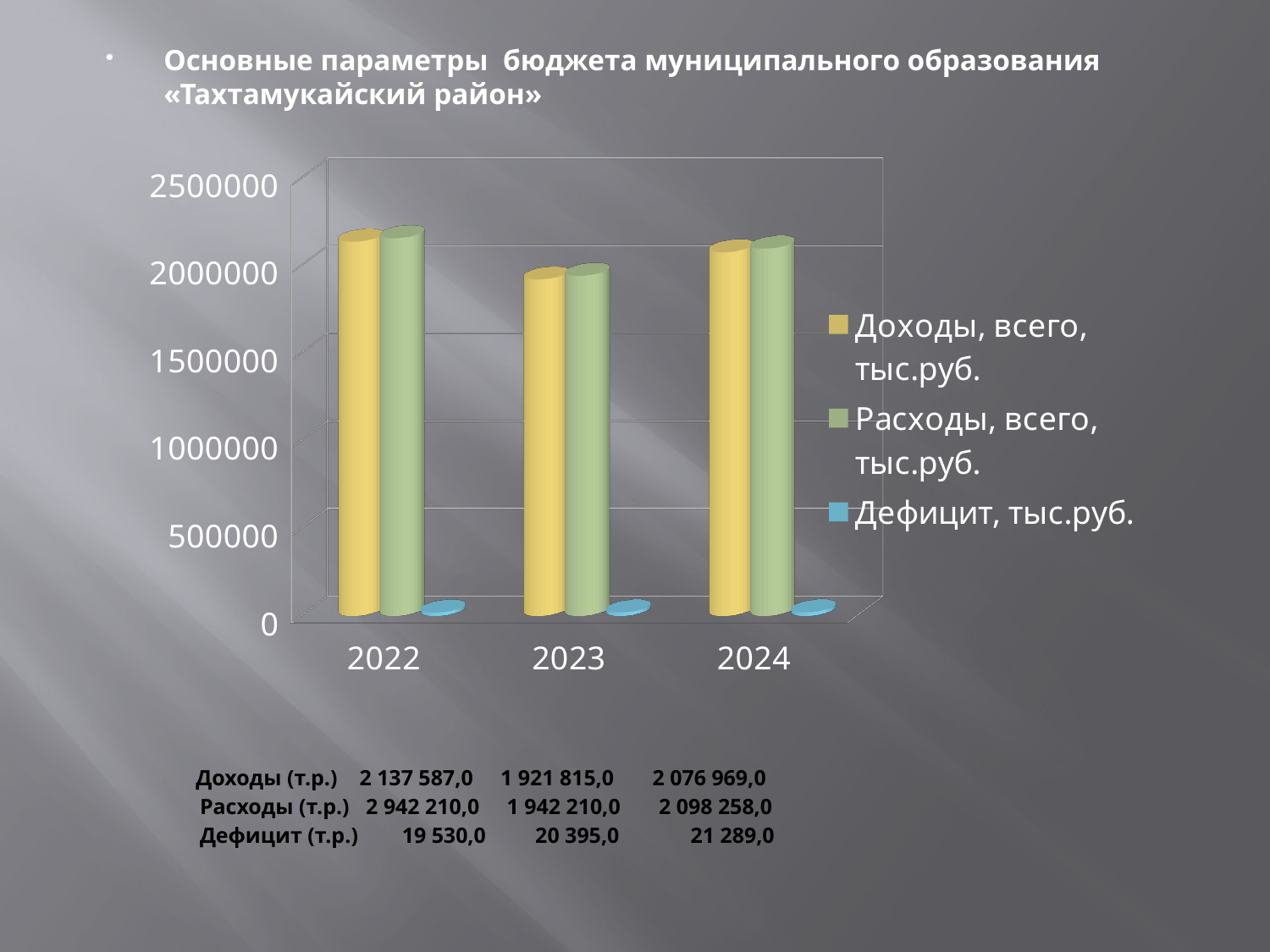
According to the figures printed below the chart, what is the value of Дефицит for 2024? 21 289,0 According to the figures printed below the chart, what is the value of Доходы for 2023? 1 921 815,0 In which year is the Доходы bar the lowest? 2023 How many years are shown on the x axis of the chart? 3 Is the Доходы value for 2023 greater or less than 2000000? less How many series does the chart legend list? 3 Using the printed figures, what is the difference between Доходы in 2022 and Доходы in 2024? 60 618,0 In which year is the Доходы bar the highest? 2022 Does the Доходы value rise or fall from 2022 to 2023? fall Is the Расходы value for 2024 greater or less than 2000000? greater According to the figures printed below the chart, what is the value of Доходы for 2022? 2 137 587,0 What type of chart is shown on the slide? bar chart